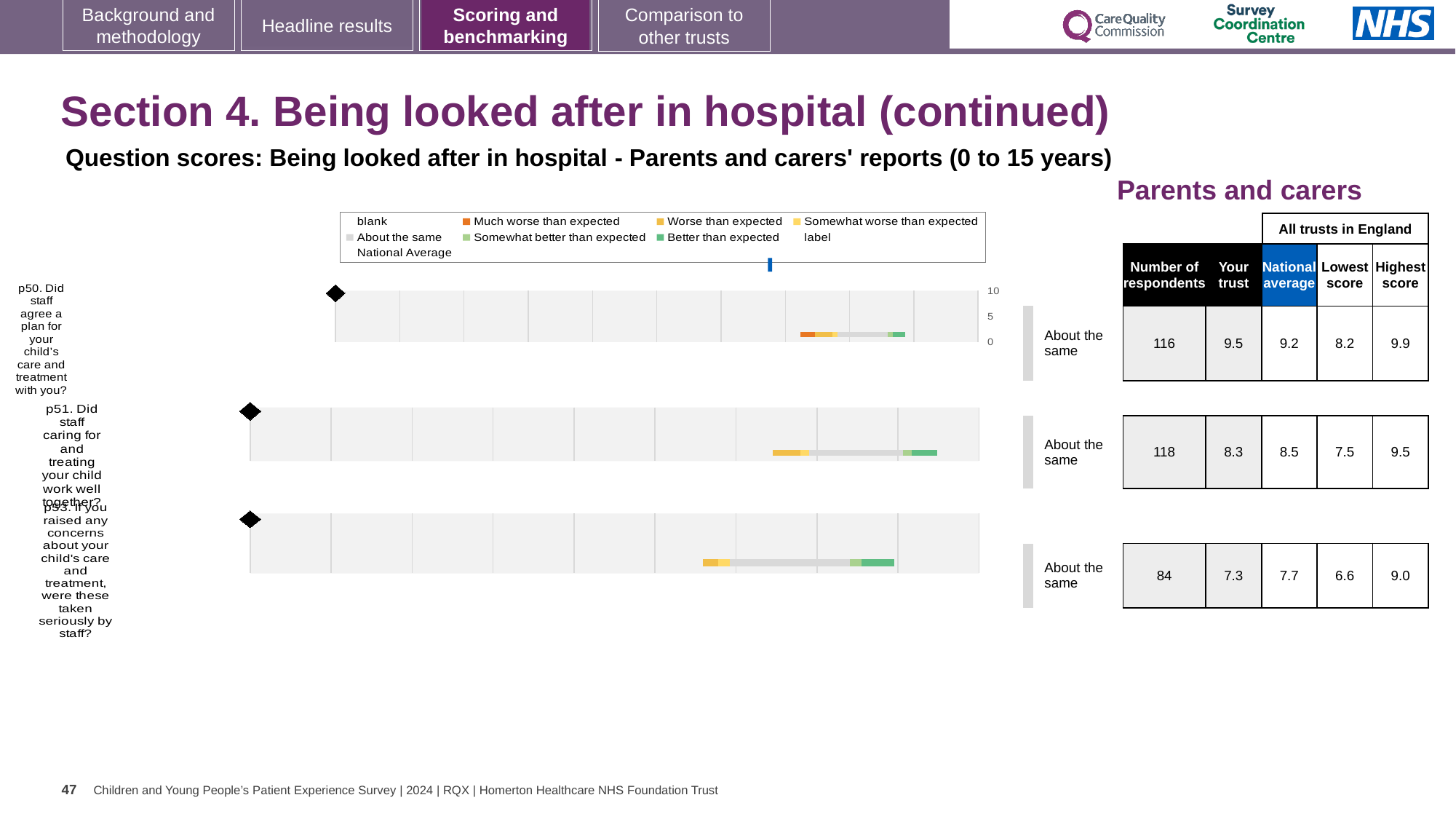
How many respondents answered p53 (If you raised any concerns about your child's care and treatment, were these taken seriously by staff?)? 84 For p51, which is higher: the 'Your trust' score or the national average? National average Which question has the highest 'Your trust' score on this slide? p50 What is the lowest score across all trusts in England for p50? 8.2 What kind of chart is used to show the question scores on this slide? Bar chart For p50, which is higher: the 'Your trust' score or the national average? Your trust What is the 'Your trust' score for p50 (Did staff agree a plan for your child's care and treatment with you?)? 9.5 What is the national average score for p51 (Did staff caring for and treating your child work well together?)? 8.5 Which question has the lowest 'Your trust' score on this slide? p53 What benchmark category is shown for p51 (Did staff caring for and treating your child work well together?)? About the same How many survey questions are plotted as bar charts on this slide? 3 What is the difference between the highest score and the lowest score for p53? 2.4